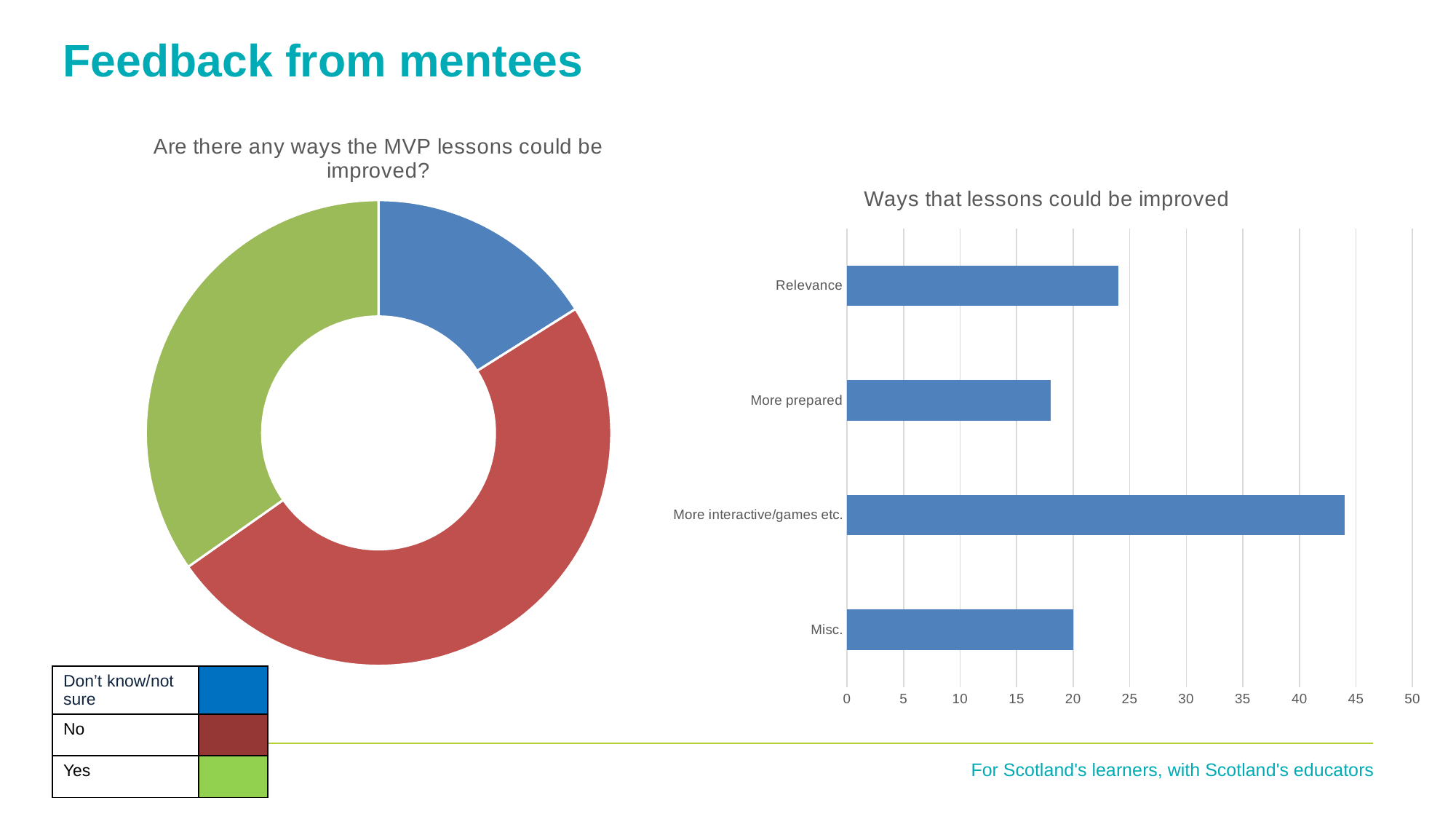
In the chart 'Ways that lessons could be improved', is the value for More prepared greater or less than 20? less In the chart 'Ways that lessons could be improved', is the value for Relevance greater or less than 20? greater What kind of chart is the chart titled 'Are there any ways the MVP lessons could be improved?'? doughnut chart In the chart 'Ways that lessons could be improved', which category has the highest value? More interactive/games etc. In the chart 'Ways that lessons could be improved', which category has the lowest value? More prepared In the chart 'Are there any ways the MVP lessons could be improved?', which response has the largest slice? No In the chart 'Ways that lessons could be improved', is the value for More interactive/games etc. greater or less than 40? greater In the chart 'Ways that lessons could be improved', how many categories are shown? 4 In the chart 'Are there any ways the MVP lessons could be improved?', what colour represents the 'Yes' response? green In the chart 'Ways that lessons could be improved', which is larger, Relevance or More prepared? Relevance What kind of chart is the chart titled 'Ways that lessons could be improved'? bar chart In the chart 'Are there any ways the MVP lessons could be improved?', which response has the smallest slice? Don't know/not sure